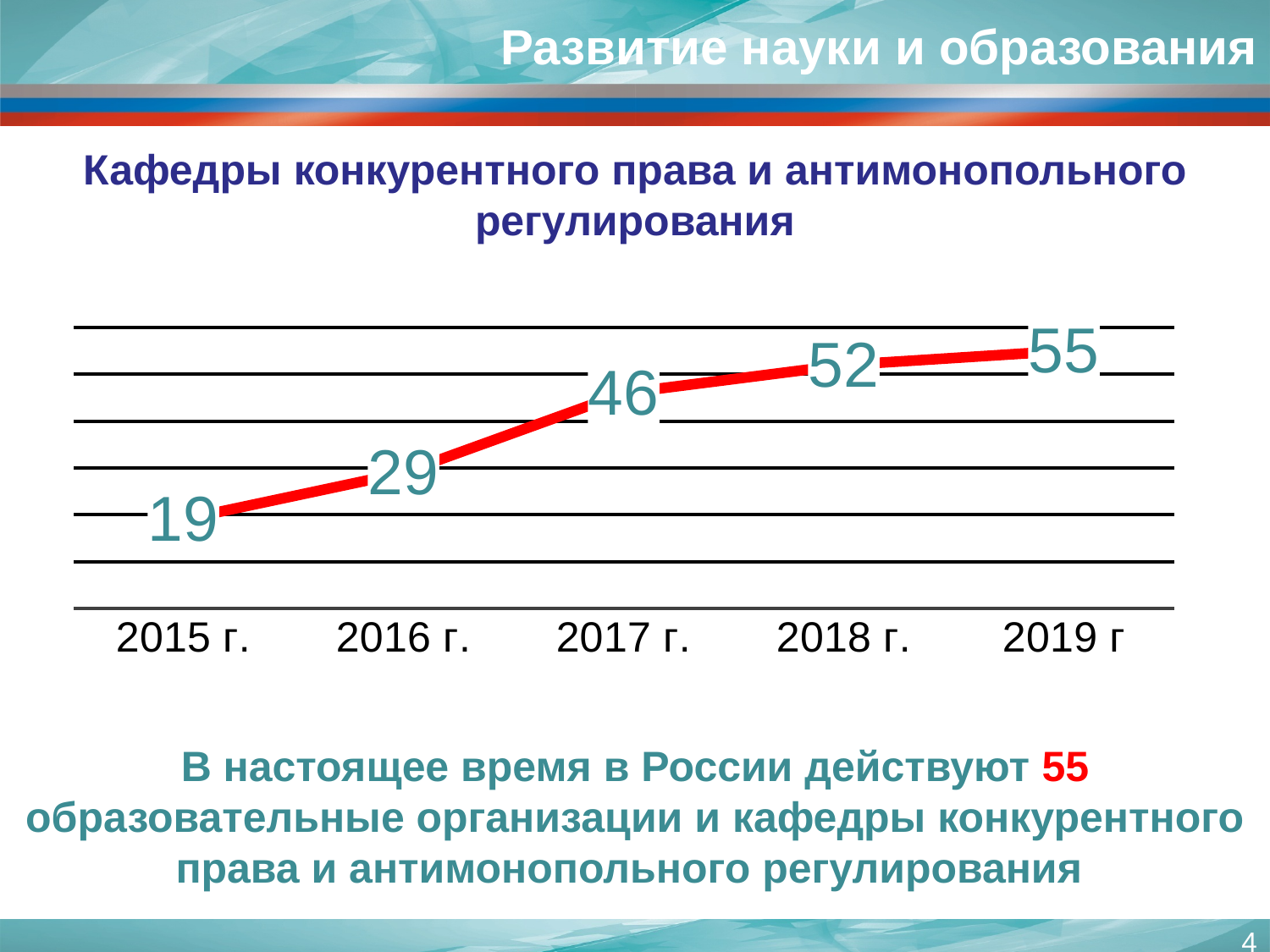
What is the value for 2019 г? 55 What is the value for 2017 г.? 46 Which year has the highest value? 2019 г Do the values rise or fall from 2015 г. to 2019 г? rise What is the difference between the values for 2017 г. and 2016 г.? 17 How many years are plotted on the chart? 5 What is the value for 2015 г.? 19 What kind of chart is shown on the slide? line chart Which is larger, the value for 2018 г. or the value for 2016 г.? 2018 г. What is the difference between the values for 2019 г and 2015 г.? 36 What is the title of the chart? Кафедры конкурентного права и антимонопольного регулирования Which year has the lowest value? 2015 г.